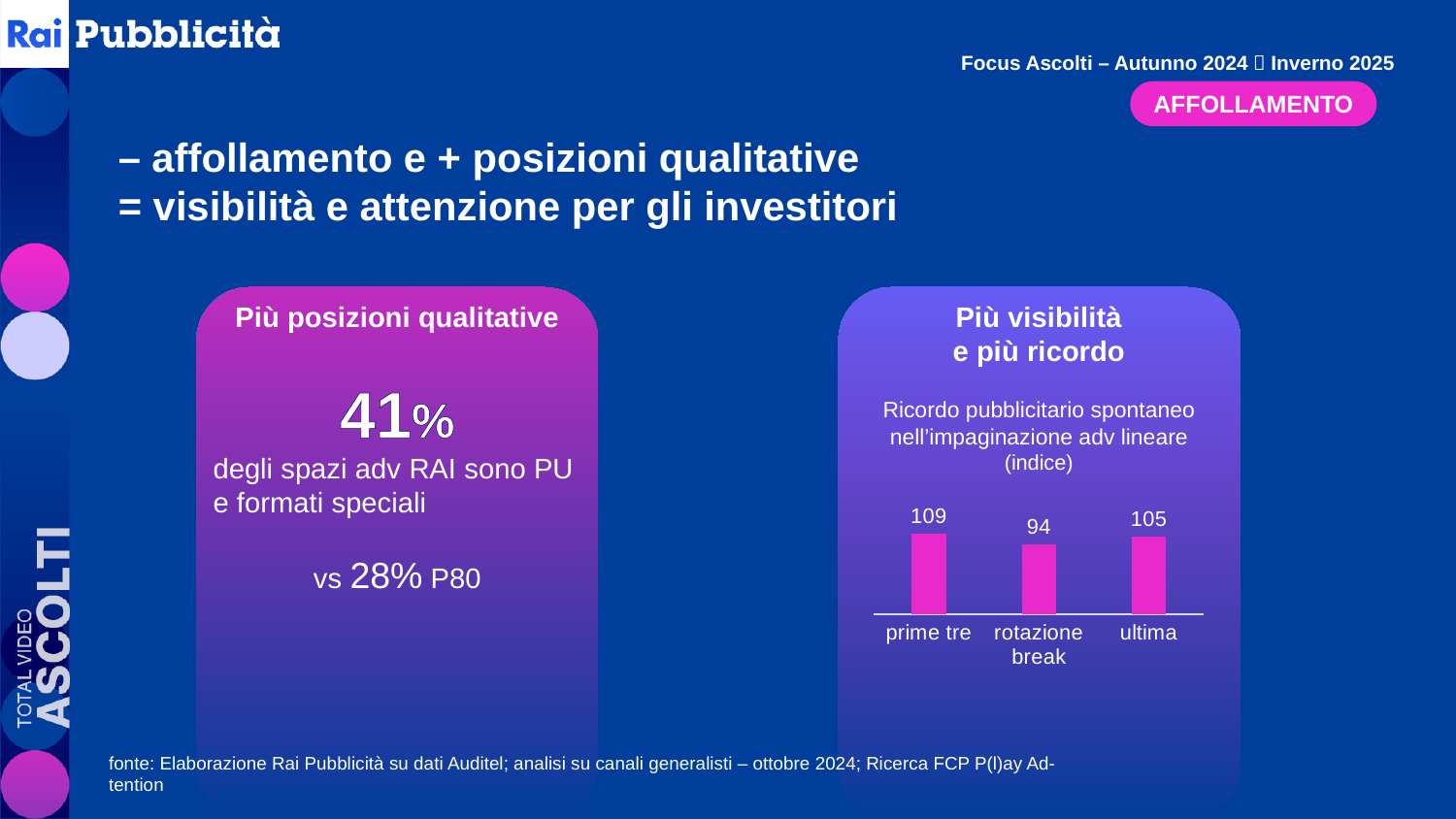
What is the difference between the values for "ultima" and "rotazione break"? 11 Which category has the highest value in the bar chart? prime tre What is the difference between the values for "prime tre" and "rotazione break"? 15 How many categories are shown in the bar chart? 3 Which category has the lowest value in the bar chart? rotazione break What is the value for "rotazione break" in the bar chart? 94 What kind of chart is shown on the slide? bar chart What is the title of the chart on the slide? Ricordo pubblicitario spontaneo nell'impaginazione adv lineare (indice) Which is larger, the value for "prime tre" or the value for "ultima"? prime tre What is the value for "prime tre" in the bar chart? 109 What colour are the bars in the chart? magenta What is the value for "ultima" in the bar chart? 105